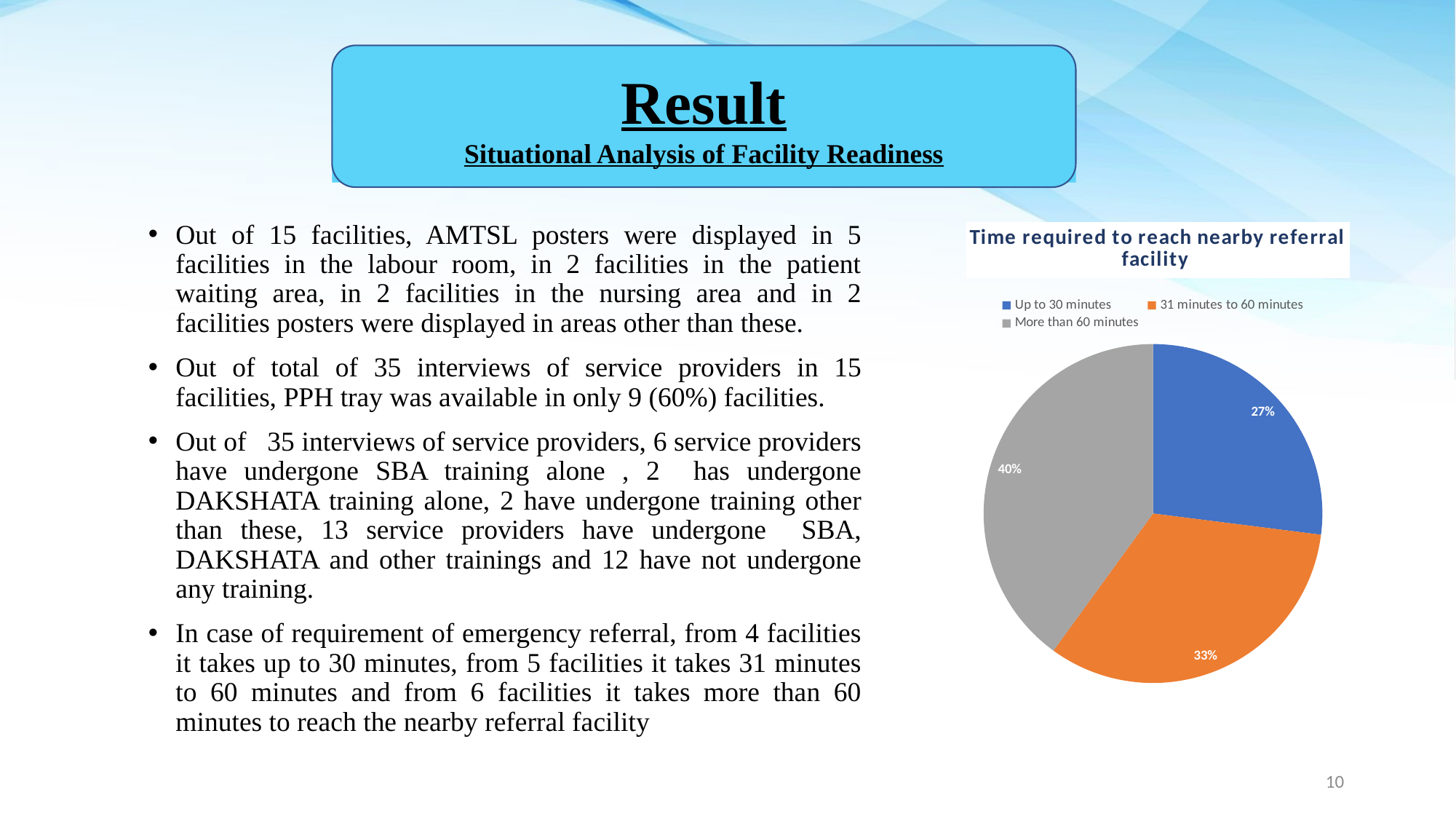
What is the title of the chart? Time required to reach nearby referral facility What share of the pie is labelled '31 minutes to 60 minutes'? 33% How many categories does the legend list? 3 Which is larger: the share for '31 minutes to 60 minutes' or the share for 'Up to 30 minutes'? 31 minutes to 60 minutes What is the combined share of the 'Up to 30 minutes' and '31 minutes to 60 minutes' slices? 60% What share of the pie is labelled 'More than 60 minutes'? 40% What share of the pie is labelled 'Up to 30 minutes'? 27% What is the difference in percentage points between the 'More than 60 minutes' slice and the 'Up to 30 minutes' slice? 13 What type of chart is shown on the slide? Pie chart Which category has the smallest share of the pie? Up to 30 minutes Which category has the largest share of the pie? More than 60 minutes What colour is the slice for 'More than 60 minutes'? Grey